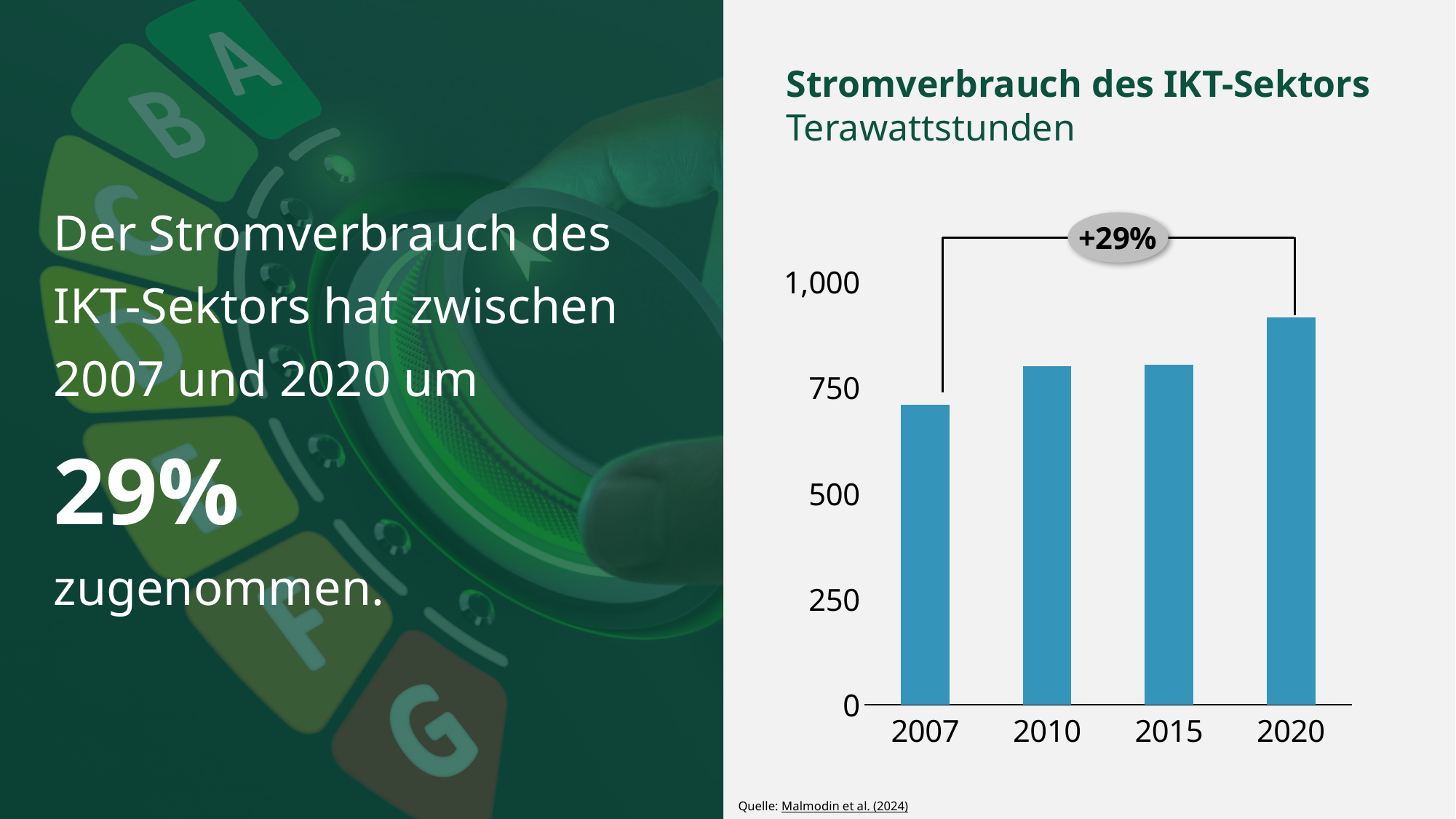
How many years are shown on the x axis of the chart? 4 Do the values rise or fall from 2007 to 2020? rise Is the value for 2010 greater or less than 750? greater Is the value for 2020 greater or less than 1,000? less What kind of chart is shown on the slide? bar chart Which year has the highest electricity consumption in the chart? 2020 Is the value for 2020 greater or less than 750? greater Which year has the larger value, 2007 or 2020? 2020 In what unit is the electricity consumption shown, according to the chart subtitle? Terawattstunden What percentage change between 2007 and 2020 is annotated on the chart? +29% Which year has the lowest electricity consumption in the chart? 2007